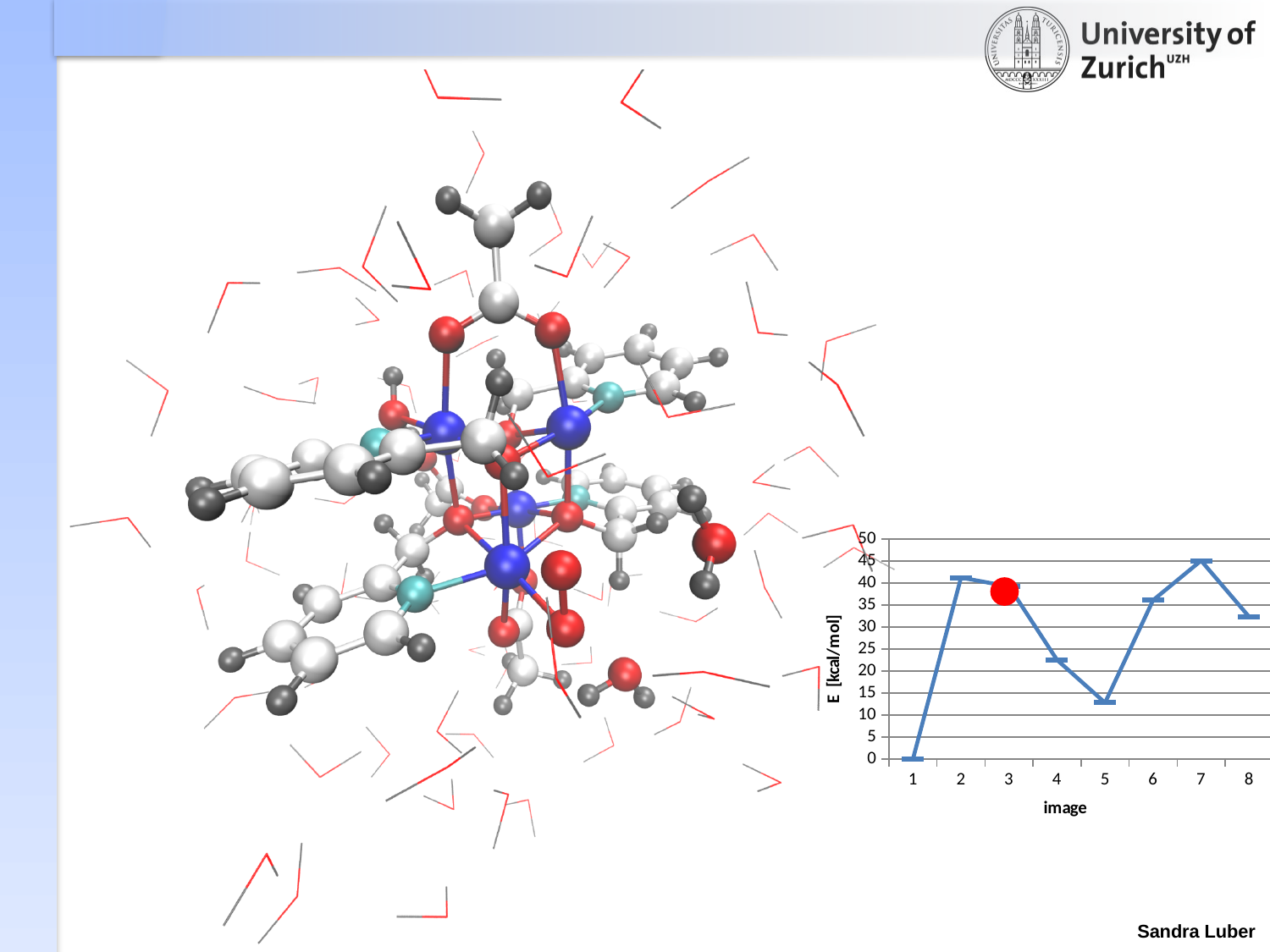
Is the value for image 5 greater or less than 15? less Which image has the lowest E [kcal/mol] value? 1 What is the label of the y axis of the chart? E [kcal/mol] Which has a larger E [kcal/mol] value, image 6 or image 8? image 6 Do the values rise or fall from image 2 to image 5? fall How many images (data points) are plotted along the x axis of the chart? 8 What is the value of E [kcal/mol] for image 1? 0 Is the value for image 4 greater or less than 25? less What kind of chart is shown on the slide? line chart What is the label of the x axis of the chart? image Which image has the highest E [kcal/mol] value? 7